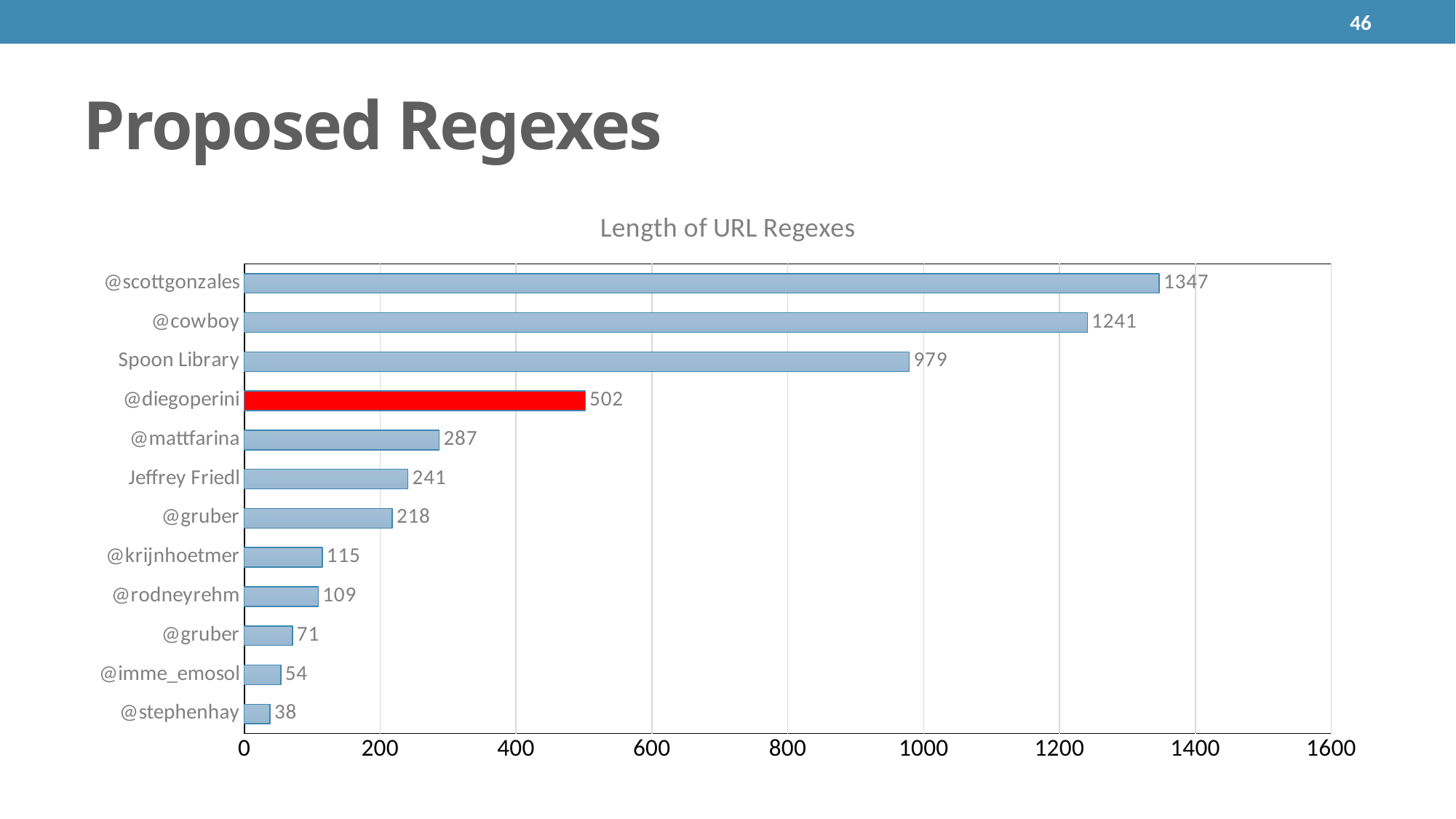
Which bar is coloured red instead of blue? @diegoperini What is the title of the chart? Length of URL Regexes Which category has the lowest value? @stephenhay How many categories are shown in the chart? 12 What is the value for @diegoperini? 502 Which is larger, the value for @mattfarina or the value for Jeffrey Friedl? @mattfarina What is the value for Spoon Library? 979 What is the difference between the values for @scottgonzales and @cowboy? 106 What is the value for @stephenhay? 38 Which category has the highest value? @scottgonzales What type of chart is shown on the slide? bar chart What is the value for @scottgonzales? 1347